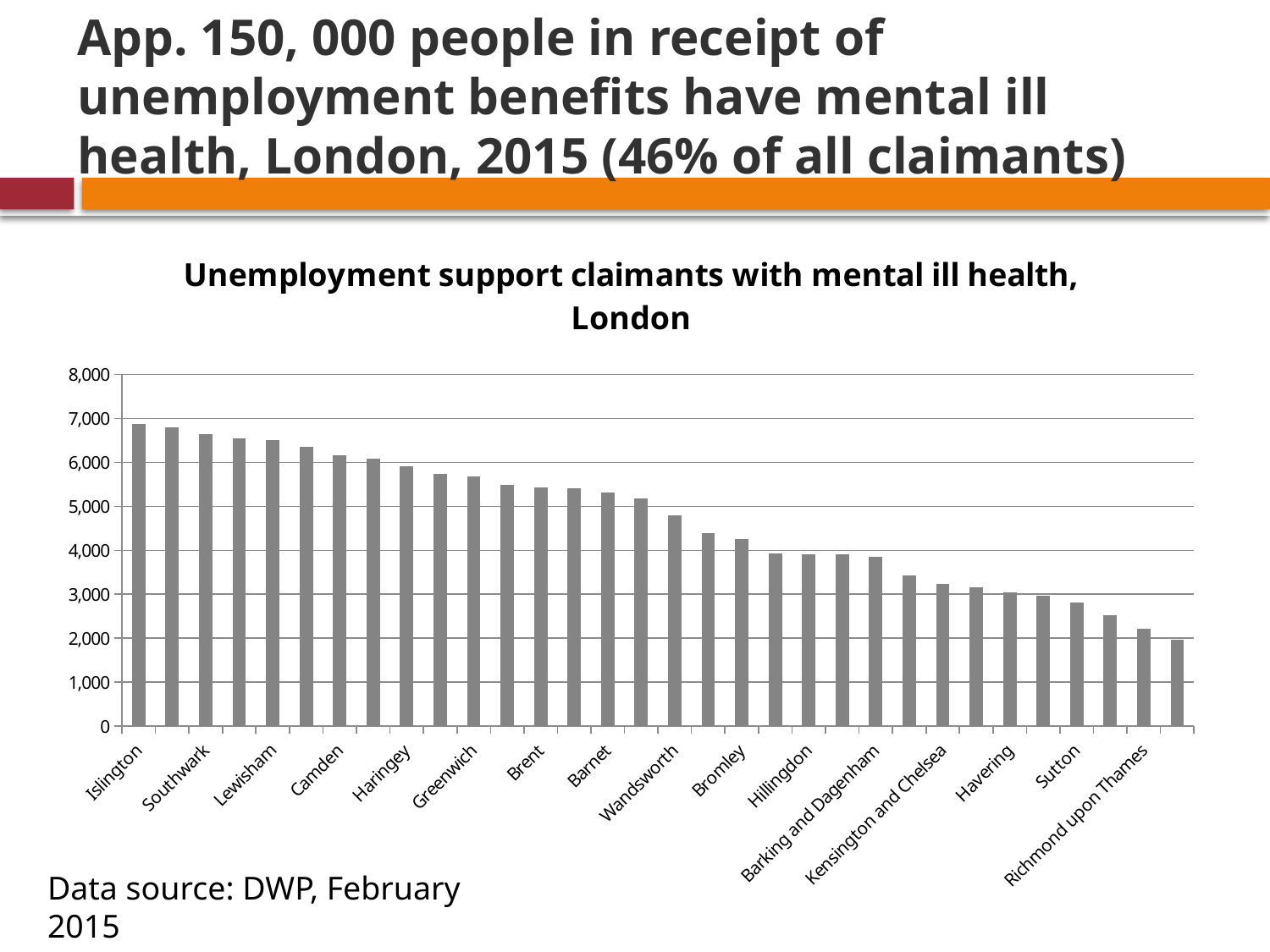
What kind of chart is shown on the slide? bar chart What is the title of the chart? Unemployment support claimants with mental ill health, London Is the value for Camden greater or less than 6,000? greater Is the value for Sutton greater or less than 3,000? less Do the values rise or fall moving from left to right along the x axis? fall Is the value for Bromley greater or less than 4,000? greater Which has more claimants with mental ill health, Camden or Bromley? Camden Which borough has the highest number of unemployment support claimants with mental ill health? Islington